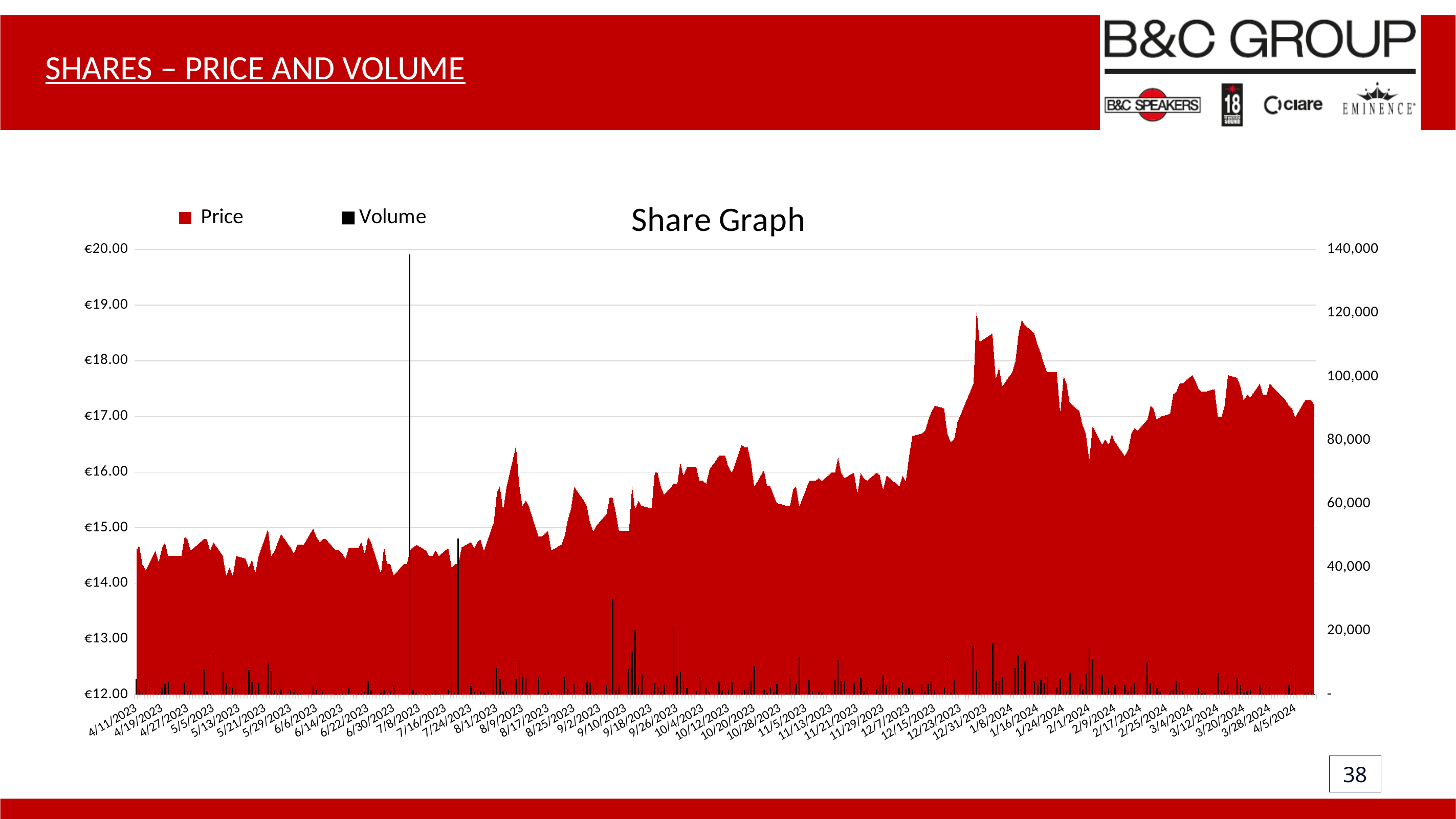
What kind of chart is used to show the Volume series? Bar chart Is the peak share price in January 2024 greater or less than €18.00? greater Does the share price generally rise or fall from April 2023 to April 2024? Rise Is the share price at the end of the chart (around 4/5/2024) greater or less than €16.00? greater Is the share price around 6/30/2023 greater or less than €15.00? less How many series does the chart legend list? 2 What is the title of the chart? Share Graph In which month does the largest volume spike occur? July 2023 In which month does the share price reach its highest point? December 2023 Which series is shown in red in the chart? Price